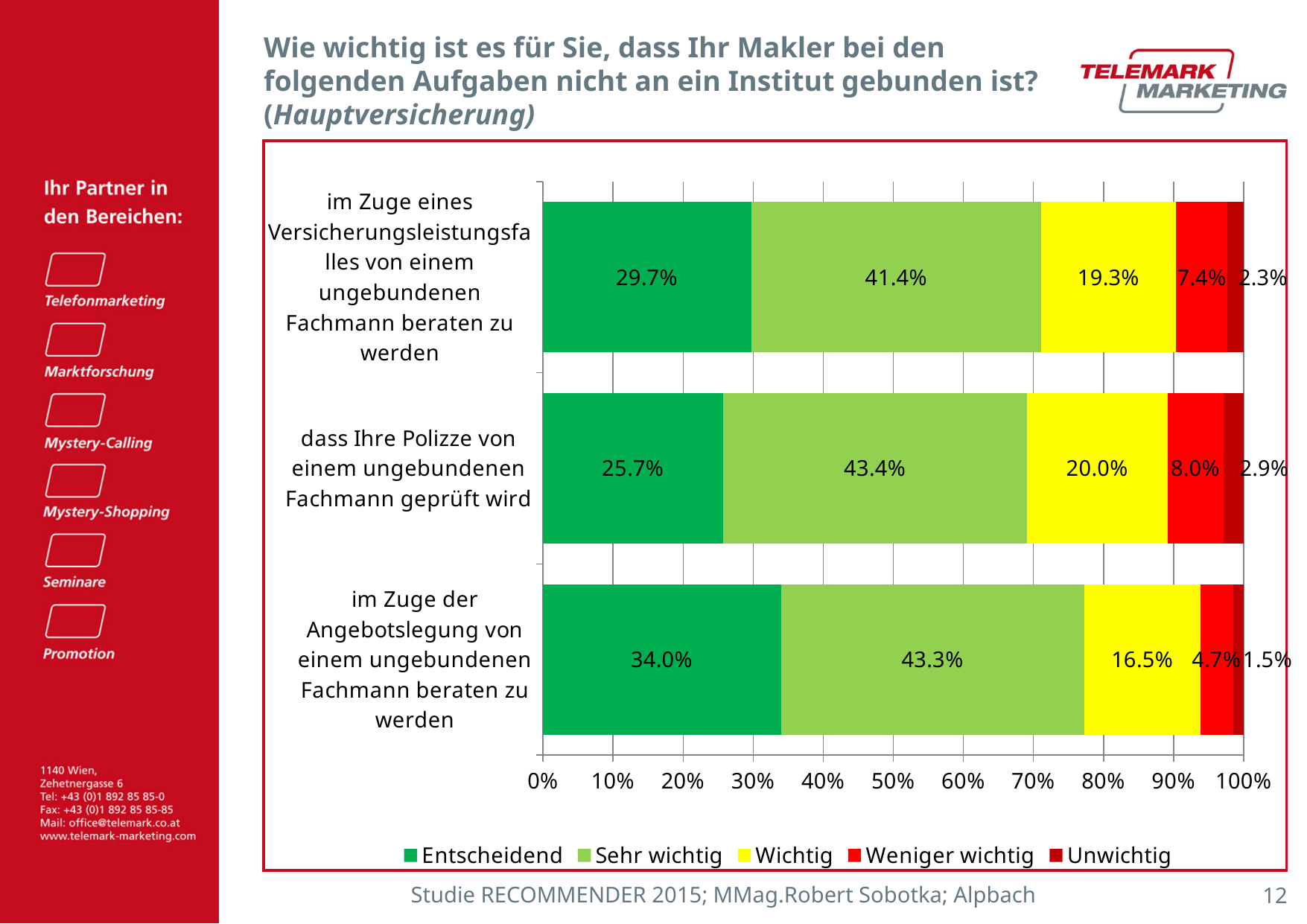
How many series does the legend list? 5 What kind of chart is shown on the slide? Stacked bar chart Which colour represents the 'Wichtig' series in the legend? Yellow What is the 'Sehr wichtig' value for 'dass Ihre Polizze von einem ungebundenen Fachmann geprüft wird'? 43.4% What is the total of the stacked bar for 'dass Ihre Polizze von einem ungebundenen Fachmann geprüft wird'? 100.0% Which is larger: the 'Wichtig' value for 'dass Ihre Polizze von einem ungebundenen Fachmann geprüft wird' or for 'im Zuge der Angebotslegung von einem ungebundenen Fachmann beraten zu werden'? dass Ihre Polizze von einem ungebundenen Fachmann geprüft wird How many categories (tasks) are plotted on the chart? 3 What is the 'Unwichtig' value for 'im Zuge eines Versicherungsleistungsfalles von einem ungebundenen Fachmann beraten zu werden'? 2.3% What is the difference between the 'Entscheidend' values for 'im Zuge der Angebotslegung...' (34.0%) and 'dass Ihre Polizze... geprüft wird' (25.7%)? 8.3% Which category has the lowest 'Weniger wichtig' share? im Zuge der Angebotslegung von einem ungebundenen Fachmann beraten zu werden What is the 'Entscheidend' value for 'im Zuge der Angebotslegung von einem ungebundenen Fachmann beraten zu werden'? 34.0% Which category has the highest 'Entscheidend' share? im Zuge der Angebotslegung von einem ungebundenen Fachmann beraten zu werden